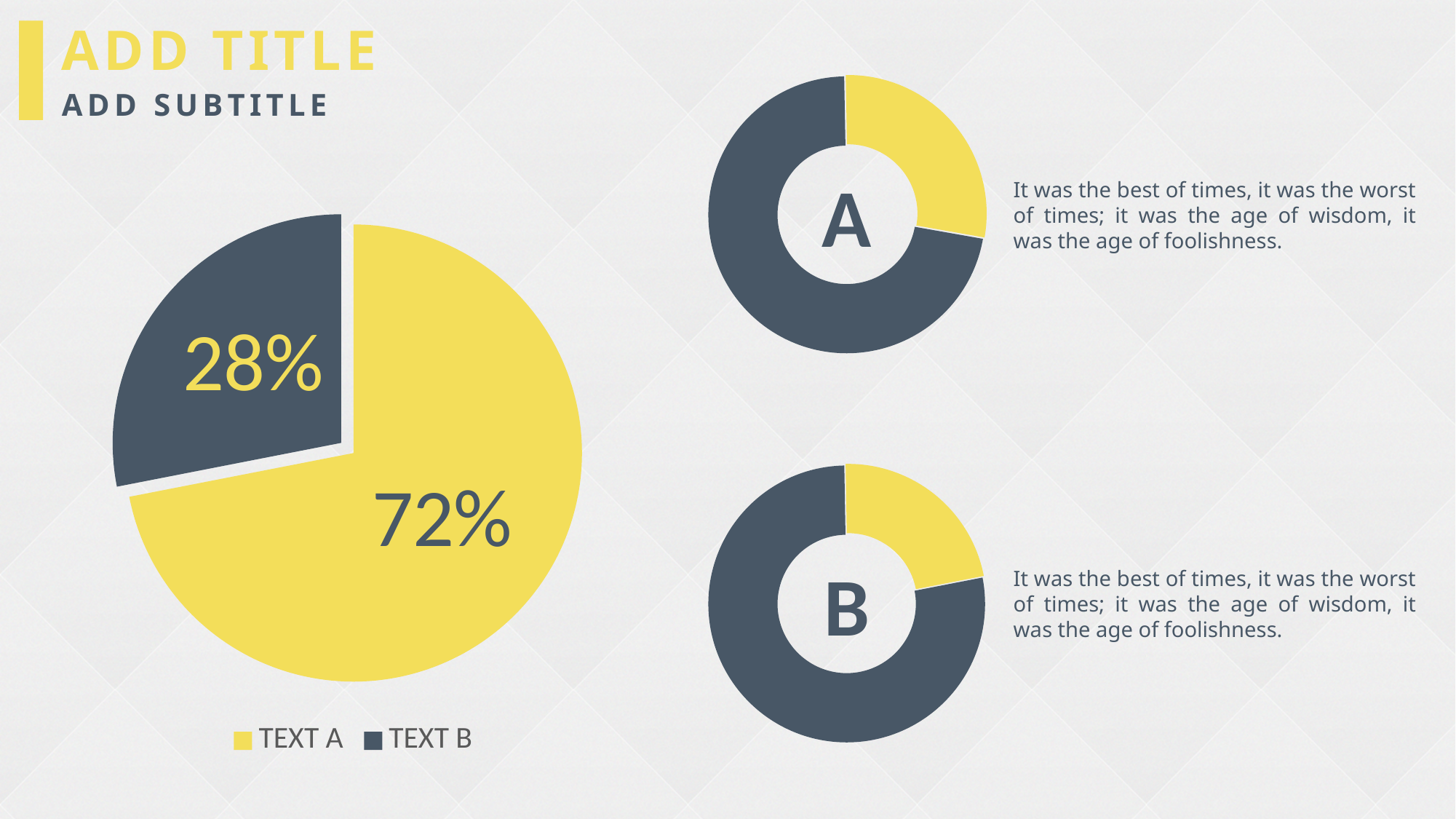
In the pie chart on the left, what colour is the TEXT B slice? Dark grey What kind of chart is the chart labelled A on the right of the slide? Donut chart How many slices does the pie chart on the left have? 2 How many entries does the legend of the pie chart on the left list? 2 In the pie chart on the left, what is the difference between the TEXT A and TEXT B values? 44% In the pie chart on the left, which category has the largest share? TEXT A What kind of chart is the chart on the left of the slide? Pie chart In the pie chart on the left, which is larger, TEXT A or TEXT B? TEXT A In the pie chart on the left, which category has the smallest share? TEXT B In the pie chart on the left, what is the value for TEXT B? 28% In the donut chart labelled B, which colour segment is larger, the yellow or the dark grey? Dark grey In the pie chart on the left, what is the value for TEXT A? 72%